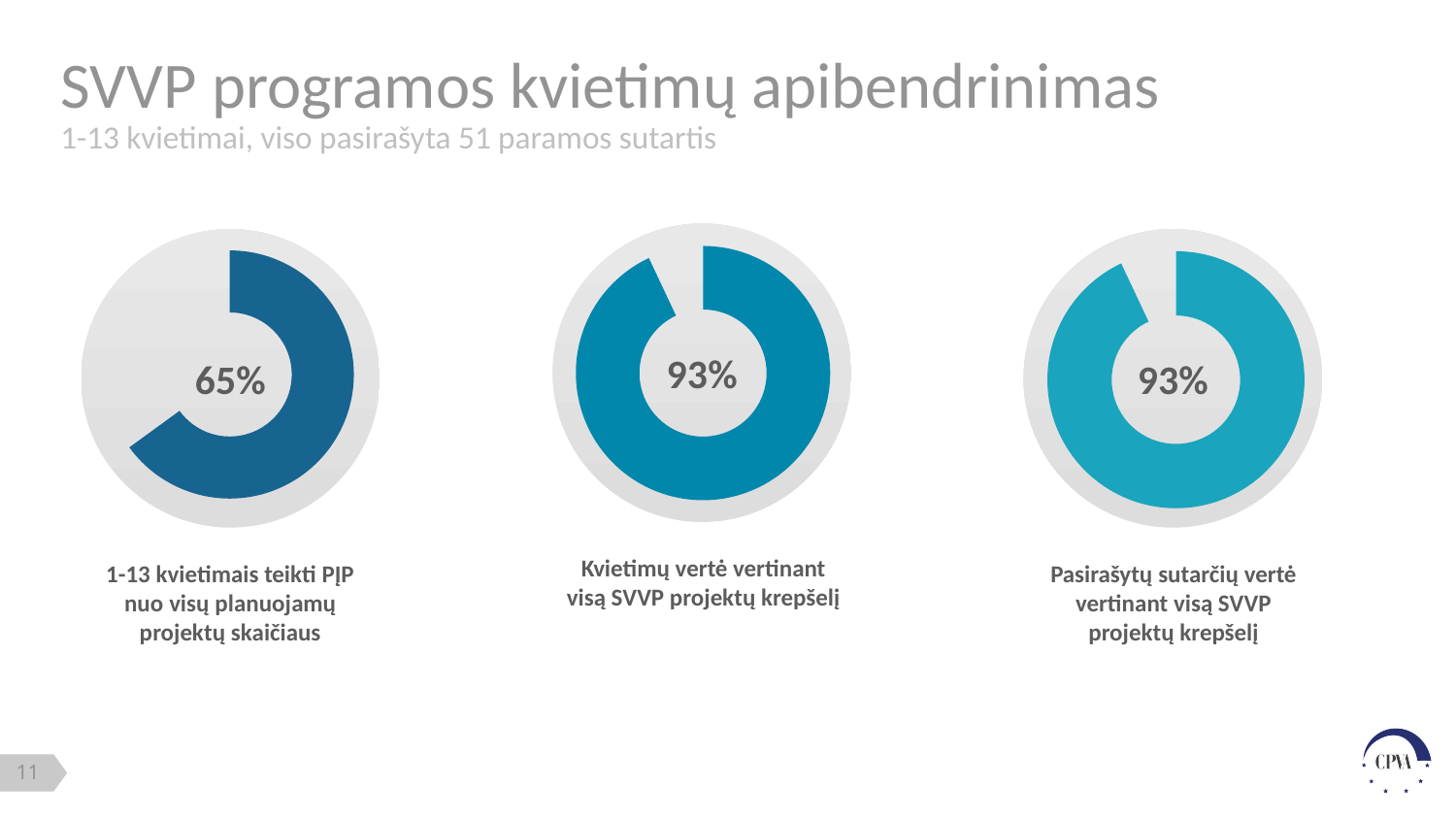
What value is shown in the centre of the left donut chart (1-13 kvietimais teikti PĮP nuo visų planuojamų projektų skaičiaus)? 65% Which shows a larger percentage: the left chart (1-13 kvietimais teikti PĮP) or the middle chart (Kvietimų vertė)? The middle chart (Kvietimų vertė) What is the title of the slide containing the three donut charts? SVVP programos kvietimų apibendrinimas Which of the three donut charts shows the lowest percentage? The left chart (1-13 kvietimais teikti PĮP nuo visų planuojamų projektų skaičiaus) How many donut charts are shown on the slide? 3 Is the value in the left donut chart greater or less than 50%? greater Do the middle and right donut charts show the same percentage? Yes, both show 93% What kind of chart is used for each of the three figures on the slide? Donut (pie) chart What is the difference in percentage points between the middle chart (93%) and the left chart (65%)? 28 percentage points What value is shown in the centre of the right donut chart (Pasirašytų sutarčių vertė vertinant visą SVVP projektų krepšelį)? 93% What value is shown in the centre of the middle donut chart (Kvietimų vertė vertinant visą SVVP projektų krepšelį)? 93% According to the slide subtitle, how many support contracts (paramos sutartis) were signed in total across calls 1-13? 51